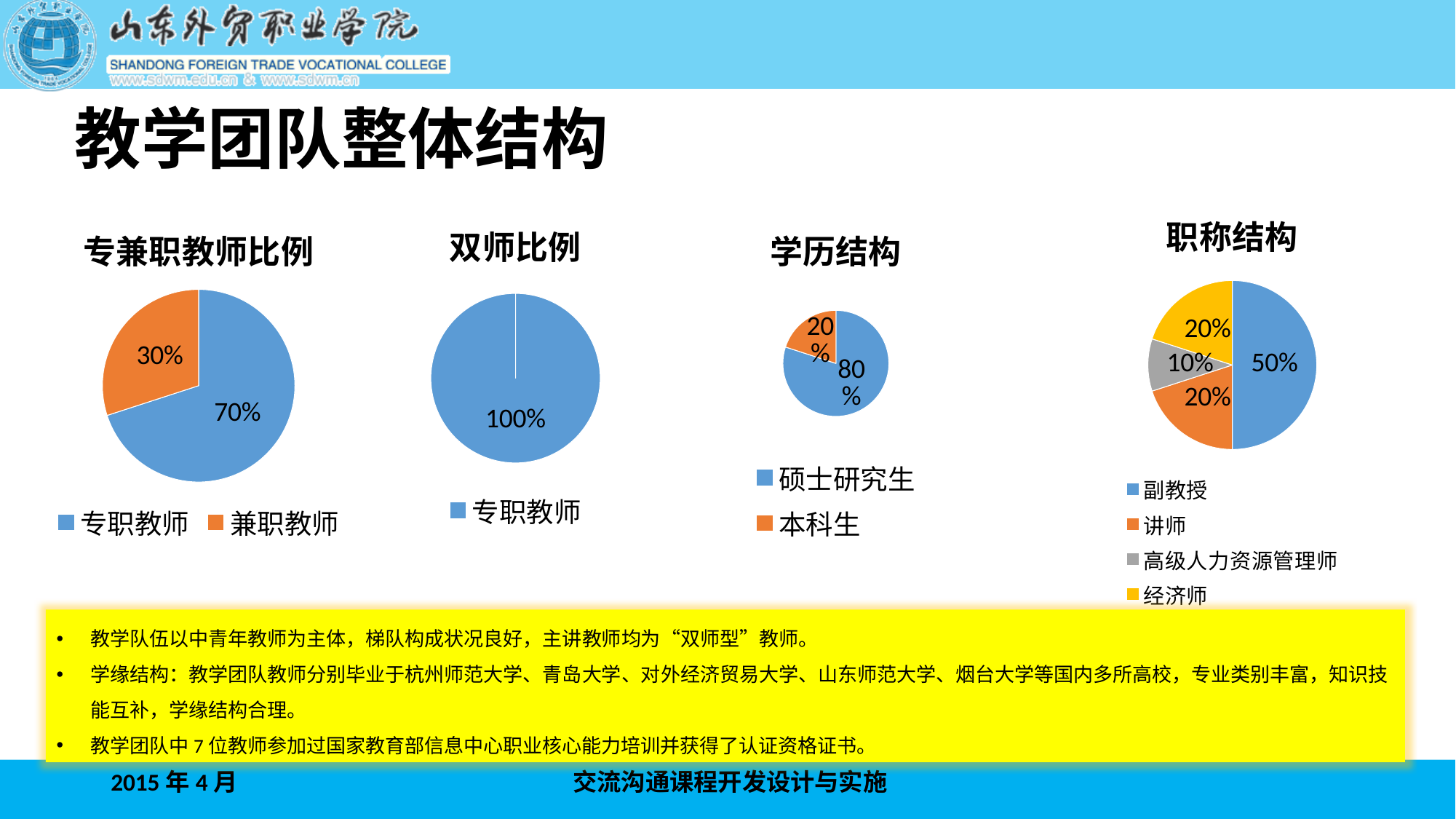
In the 职称结构 chart, which is larger, 副教授 or 讲师? 副教授 How many entries does the legend of the 职称结构 chart list? 4 How many slices does the 双师比例 chart have? 1 What kind of chart is the 学历结构 chart? pie chart In the 双师比例 chart, what share is 专职教师? 100% In the 专兼职教师比例 chart, what share is 兼职教师? 30% In the 学历结构 chart, what share is 硕士研究生? 80% In the 职称结构 chart, what share is 副教授? 50% In the 学历结构 chart, which category has the smallest share? 本科生 In the 职称结构 chart, which category has the smallest share? 高级人力资源管理师 In the 专兼职教师比例 chart, what is the difference between the 专职教师 and 兼职教师 shares? 40% In the 专兼职教师比例 chart, what share is 专职教师? 70%